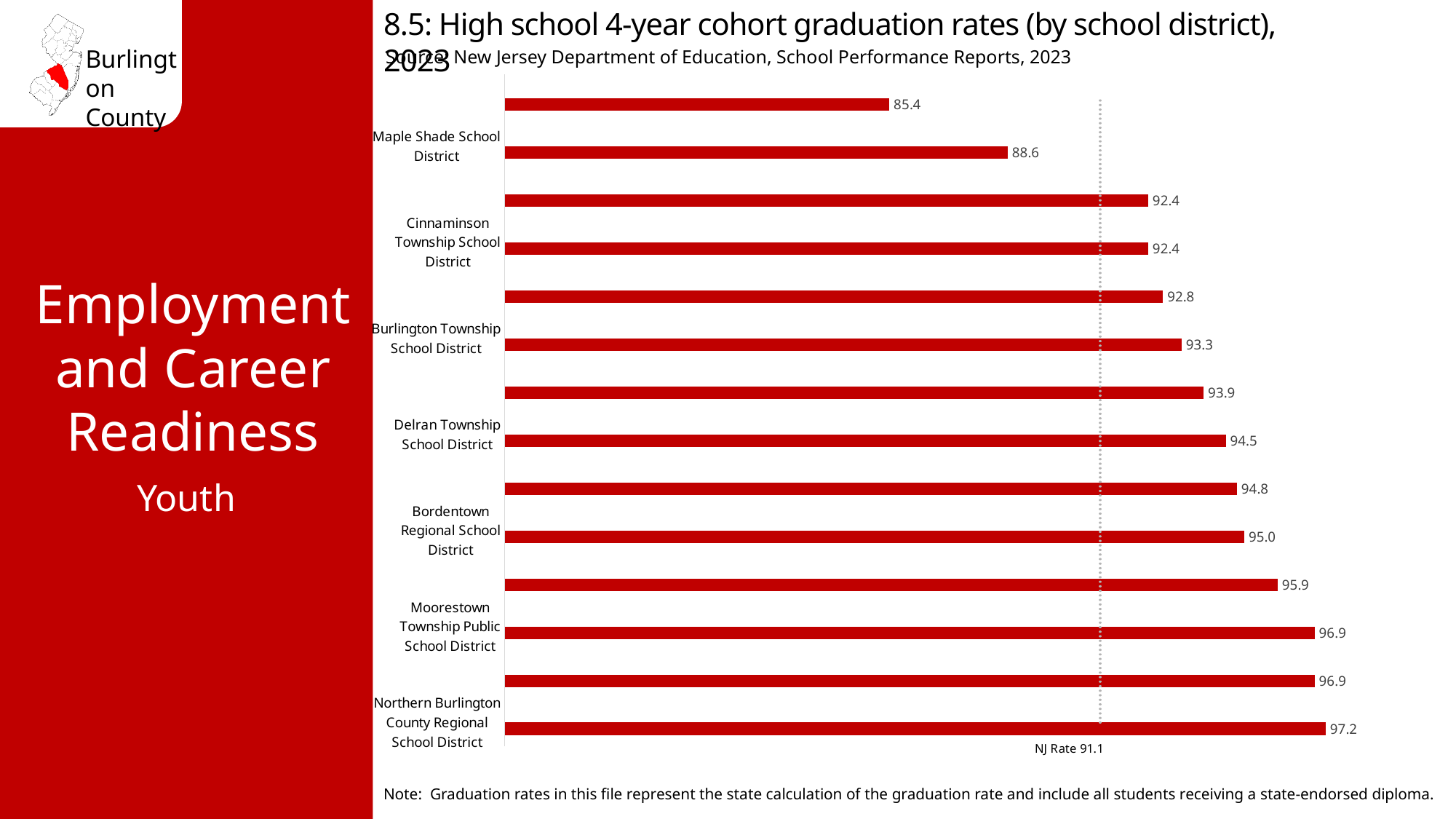
What is the lowest graduation rate shown in the chart? 85.4 What is the source cited for the chart data? New Jersey Department of Education, School Performance Reports, 2023 What is the difference between the highest and lowest graduation rates shown? 11.8 What NJ rate is marked by the dotted reference line? 91.1 How many bars are plotted in the chart? 14 Is the value of the top bar (85.4) greater or less than the NJ Rate of 91.1? less What is the graduation rate for the bar labeled Northern Burlington County Regional School District? 97.2 What is the graduation rate for the bar labeled Maple Shade School District? 88.6 Do the bar values increase or decrease from the top of the chart to the bottom? increase What kind of chart is shown on the slide? bar chart What is the highest graduation rate shown in the chart? 97.2 How many bars fall below the NJ Rate line of 91.1? 2